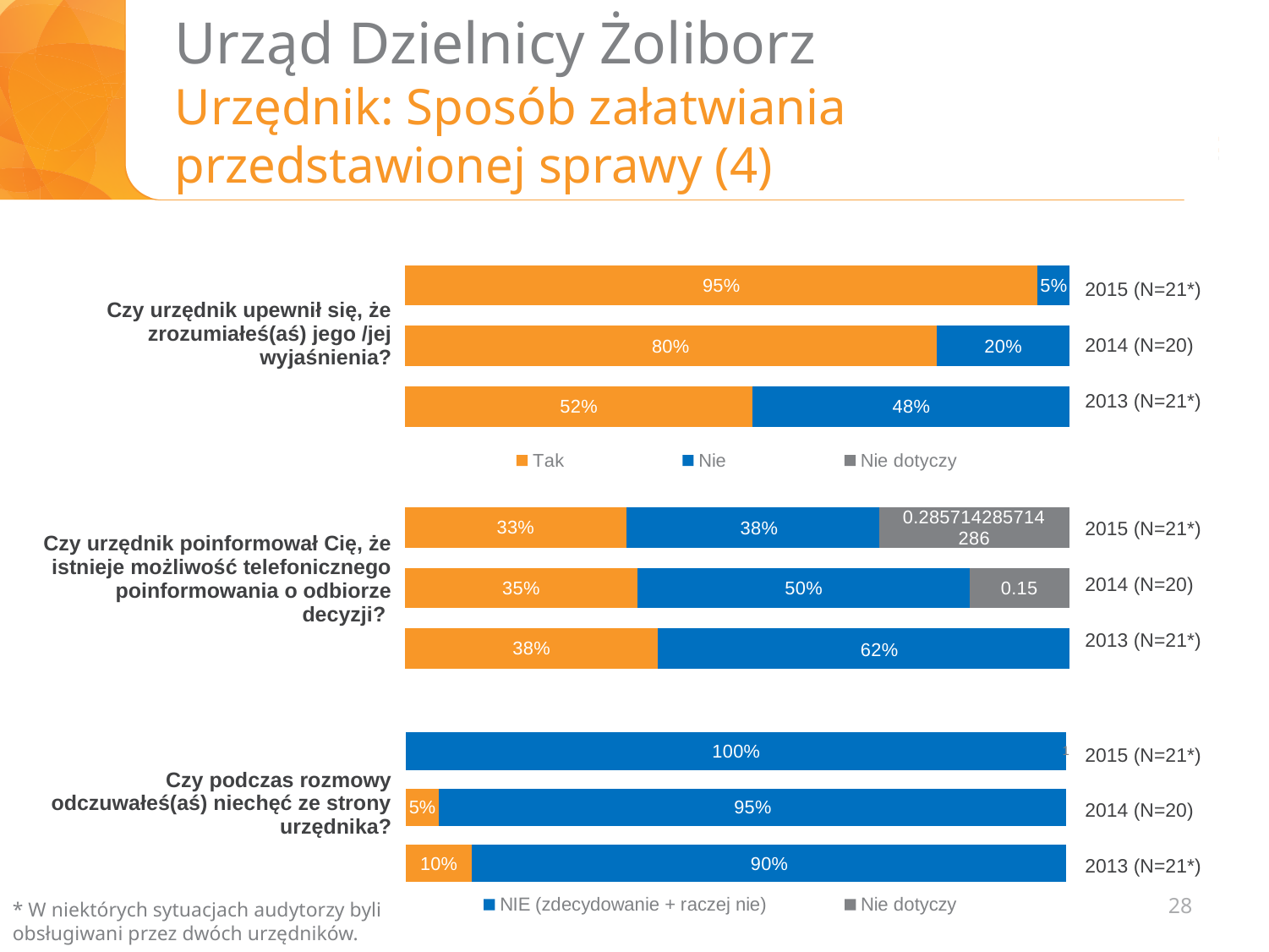
In the chart for "Czy urzędnik poinformował Cię, że istnieje możliwość telefonicznego poinformowania o odbiorze decyzji?", what is the "Nie dotyczy" value printed for 2014 (N=20)? 0.15 What kind of chart is used for "Czy podczas rozmowy odczuwałeś(aś) niechęć ze strony urzędnika?"? Stacked bar chart In the chart for "Czy urzędnik upewnił się, że zrozumiałeś(aś) jego /jej wyjaśnienia?", which year has the highest "Tak" value? 2015 (N=21*) In the chart for "Czy urzędnik upewnił się, że zrozumiałeś(aś) jego /jej wyjaśnienia?", what is the "Tak" value for 2015 (N=21*)? 95% In the chart for "Czy urzędnik upewnił się, że zrozumiałeś(aś) jego /jej wyjaśnienia?", what is the difference between the "Tak" values for 2014 (N=20) and 2013 (N=21*)? 28% In the chart for "Czy podczas rozmowy odczuwałeś(aś) niechęć ze strony urzędnika?", what is the "NIE (zdecydowanie + raczej nie)" value for 2013 (N=21*)? 90% In the chart for "Czy urzędnik poinformował Cię, że istnieje możliwość telefonicznego poinformowania o odbiorze decyzji?", which year has the highest "Nie" value? 2013 (N=21*) In the chart for "Czy urzędnik upewnił się, że zrozumiałeś(aś) jego /jej wyjaśnienia?", how many series does the legend list? 3 In the chart for "Czy podczas rozmowy odczuwałeś(aś) niechęć ze strony urzędnika?", what is the "NIE (zdecydowanie + raczej nie)" value for 2015 (N=21*)? 100% In the chart for "Czy urzędnik upewnił się, że zrozumiałeś(aś) jego /jej wyjaśnienia?", what is the "Nie" value for 2013 (N=21*)? 48% In the chart for "Czy urzędnik poinformował Cię, że istnieje możliwość telefonicznego poinformowania o odbiorze decyzji?", what is the "Nie" value for 2014 (N=20)? 50% In the chart for "Czy urzędnik poinformował Cię, że istnieje możliwość telefonicznego poinformowania o odbiorze decyzji?", is the "Tak" value larger for 2015 (N=21*) or 2013 (N=21*)? 2013 (N=21*)